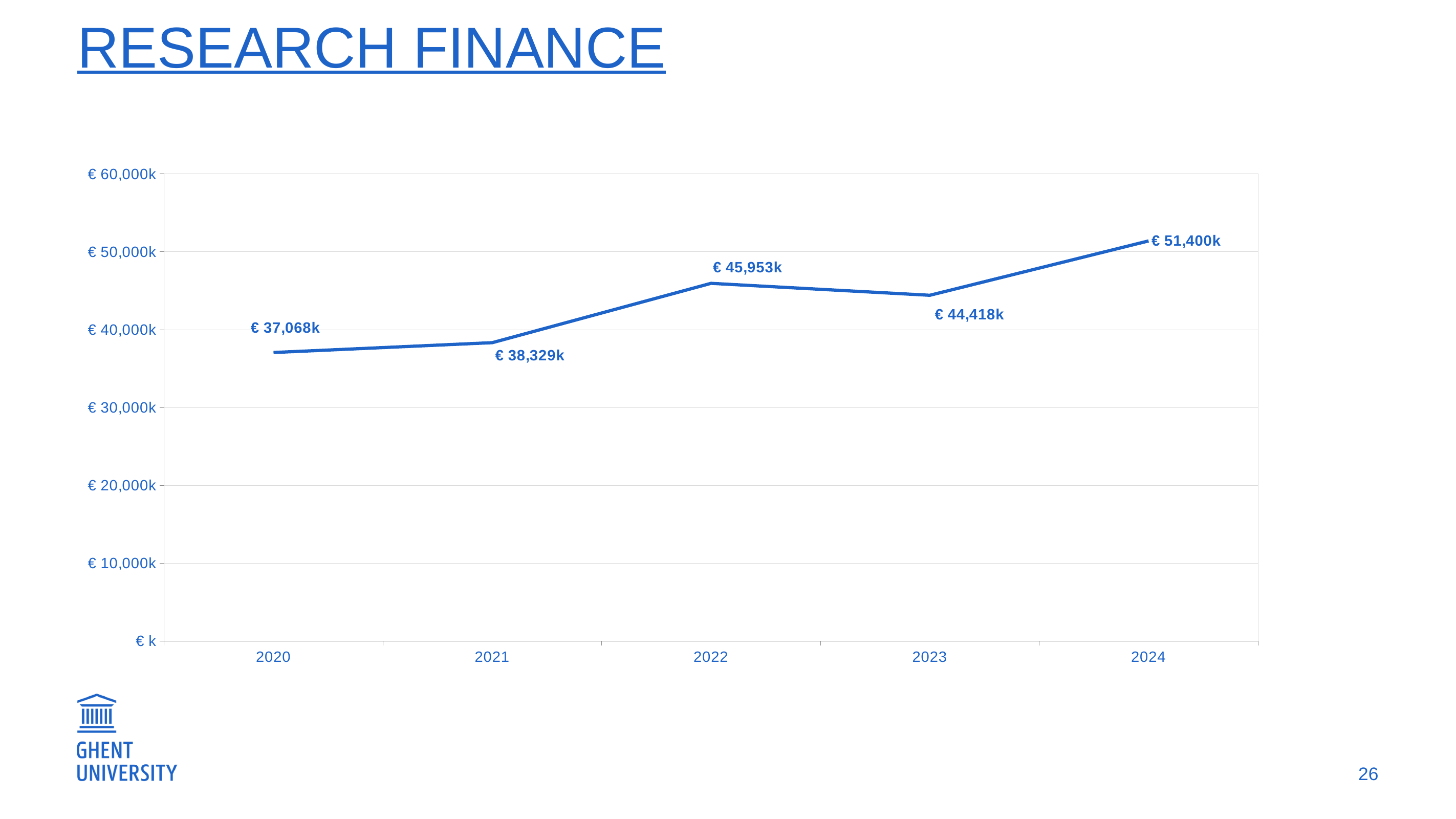
What is the difference between the values for 2021 and 2020? € 1,261k What is the value for 2024? € 51,400k Which year has the lowest value? 2020 What is the value for 2020? € 37,068k Which year has the highest value? 2024 What kind of chart is shown on the slide? line chart Does the value rise or fall from 2022 to 2023? fall What is the value for 2022? € 45,953k What is the difference between the values for 2024 and 2023? € 6,982k Which is larger, the value for 2022 or the value for 2023? 2022 Is the value for 2024 greater or less than € 50,000k? greater How many years are plotted on the chart? 5